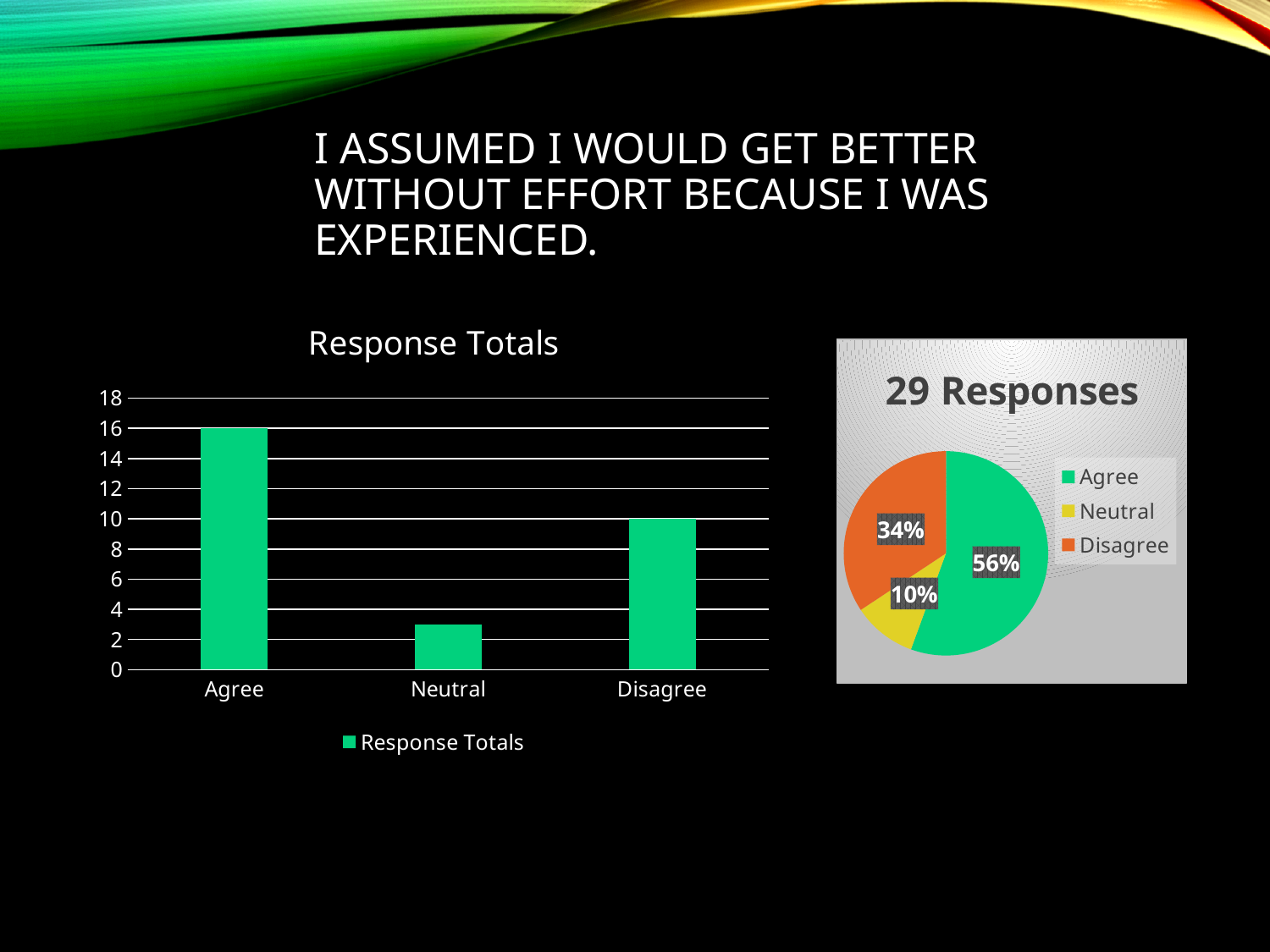
In the Response Totals bar chart, is the value for Neutral greater or less than 4? less In the Response Totals bar chart, how many categories are shown on the x axis? 3 How many entries does the legend of the 29 Responses pie chart list? 3 In the 29 Responses pie chart, what share does Agree have? 56% In the 29 Responses pie chart, which slice is larger, Neutral or Disagree? Disagree In the Response Totals bar chart, which category has the lowest value? Neutral What kind of chart is the Response Totals chart on the left? bar chart In the Response Totals bar chart, what is the value for Agree? 16 In the Response Totals bar chart, what is the difference between the values for Agree and Disagree? 6 In the Response Totals bar chart, what is the value for Disagree? 10 In the 29 Responses pie chart, what share does Disagree have? 34% In the Response Totals bar chart, which category has the highest value? Agree